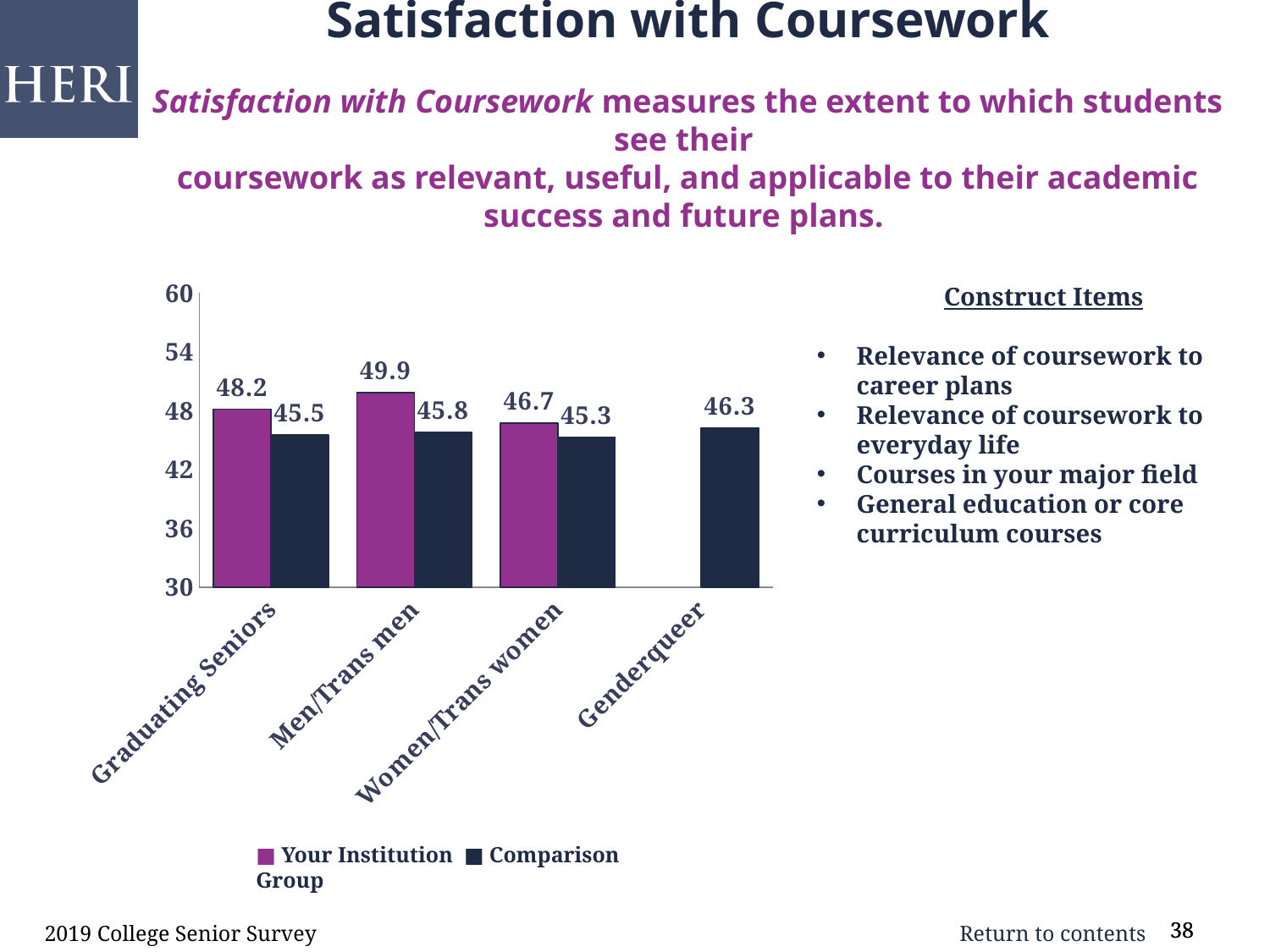
What is the difference between the Your Institution and Comparison Group values for Men/Trans men? 4.1 Which category has the lowest Comparison Group value? Women/Trans women For Women/Trans women, which is larger: the Your Institution value or the Comparison Group value? Your Institution What is the Comparison Group value for Men/Trans men? 45.8 What is the Your Institution value for Graduating Seniors? 48.2 How many categories are shown on the x axis? 4 Which category has no Your Institution bar? Genderqueer What is the Comparison Group value for Genderqueer? 46.3 How many series does the legend list? 2 What kind of chart is shown on the slide? bar chart Which category has the highest Your Institution value? Men/Trans men Is the Your Institution value for Graduating Seniors greater or less than 48? greater